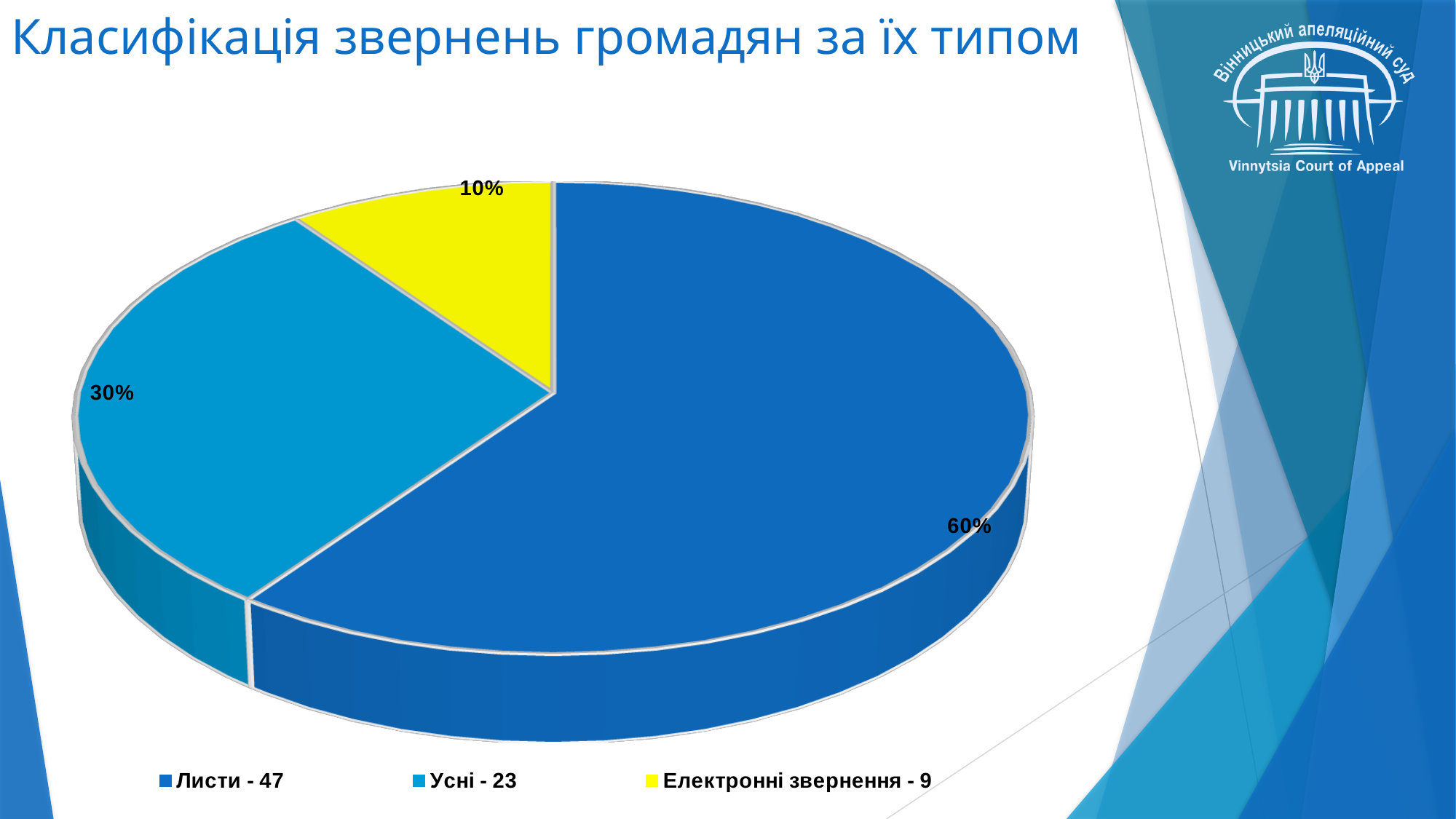
Which slice is larger, "Усні - 23" or "Електронні звернення - 9"? Усні - 23 Which category has the largest slice of the pie? Листи - 47 What percentage share does the "Усні - 23" slice have? 30% What percentage share does the "Листи - 47" slice have? 60% What colour is the "Електронні звернення - 9" slice? yellow What is the title of the chart on the slide? Класифікація звернень громадян за їх типом What is the difference in percentage points between the "Листи" slice and the "Усні" slice? 30 How many slices does the pie chart have? 3 How many entries does the legend list? 3 What percentage share does the "Електронні звернення - 9" slice have? 10% Which category has the smallest slice of the pie? Електронні звернення - 9 What kind of chart is shown on the slide? pie chart